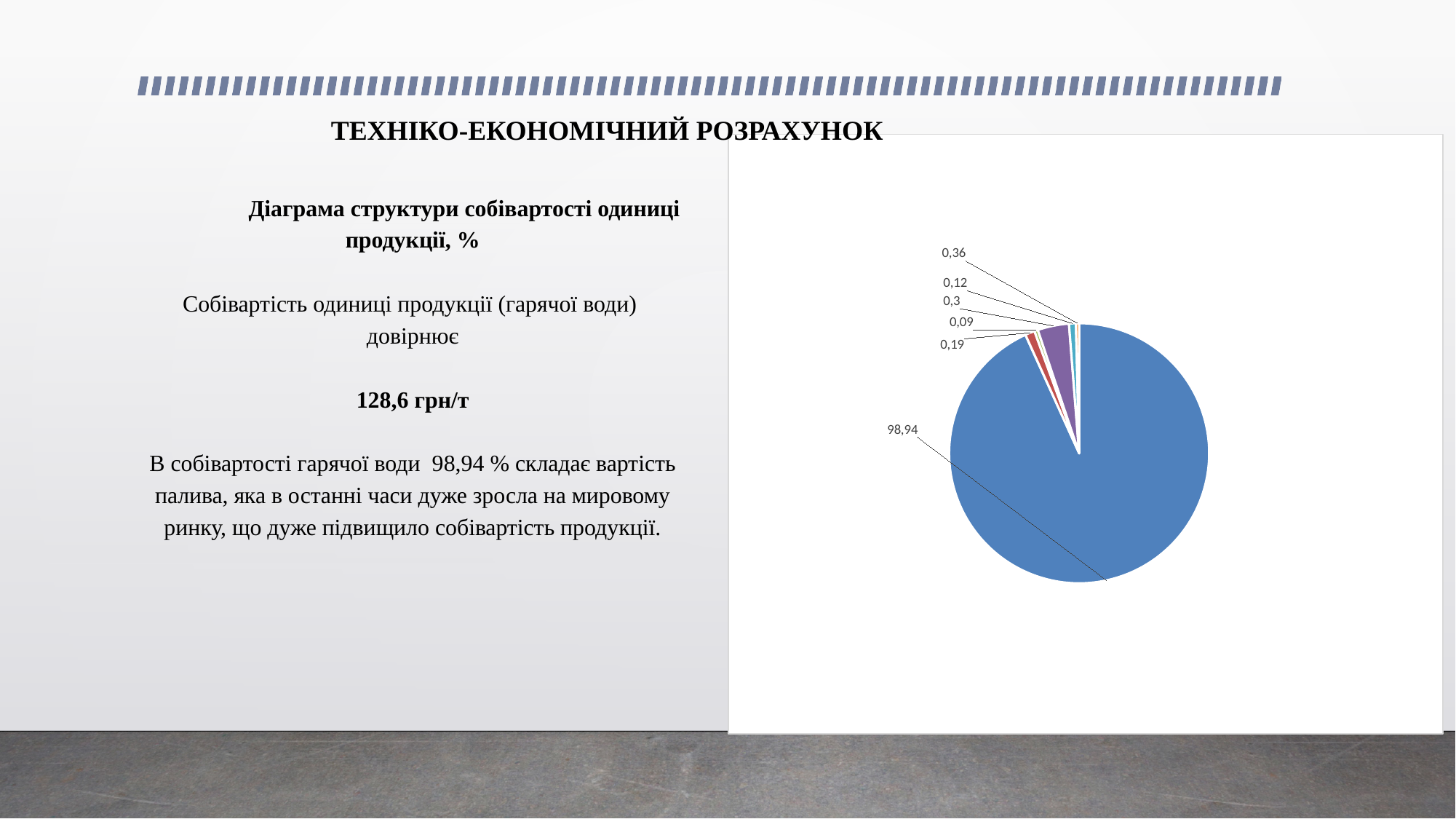
What colour is the largest slice of the pie chart? blue What is the value of the largest slice of the pie chart? 98,94 Is the largest slice of the pie chart greater or less than 90? greater What kind of chart is shown on the slide? pie chart What is the sum of all the values labelled on the pie chart? 100 Which is larger among the small slices of the pie chart: the one labelled 0,3 or the one labelled 0,19? 0,3 How many slices does the pie chart have? 6 What is the smallest value labelled on the pie chart? 0,09 What share of the pie does the largest slice represent? 98,94% According to the slide, what does the pie chart show the structure of? собівартості одиниці продукції, % What is the difference between the slices labelled 0,19 and 0,09 on the pie chart? 0,1 What is the difference between the slices labelled 0,36 and 0,12 on the pie chart? 0,24